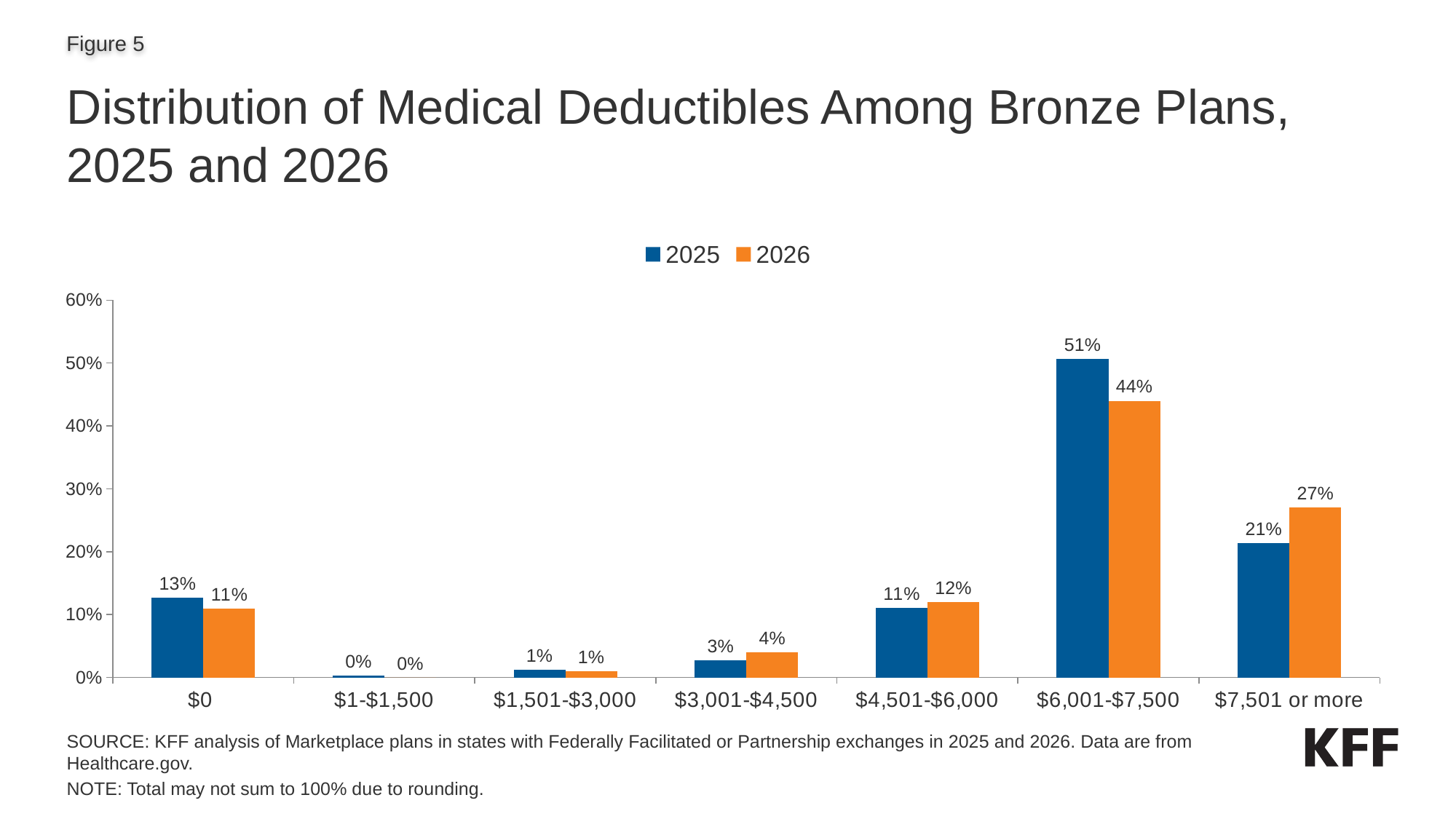
What share of bronze plans had a medical deductible of $6,001-$7,500 in 2025? 51% How many series does the legend list? 2 For the $7,501 or more category, which year has the larger share, 2025 or 2026? 2026 Is the 2025 value for the $6,001-$7,500 category greater or less than 50%? greater What is the 2026 value for the $0 deductible category? 11% Which deductible category has the highest share of bronze plans in 2026? $6,001-$7,500 What kind of chart is shown on the slide? Bar chart What is the difference between the 2025 and 2026 values for the $6,001-$7,500 category? 7 percentage points What share of bronze plans had a medical deductible of $7,501 or more in 2026? 27% How many deductible categories are shown on the x axis? 7 Which colour represents the 2026 series? Orange Which deductible category has the lowest share of bronze plans in 2025? $1-$1,500